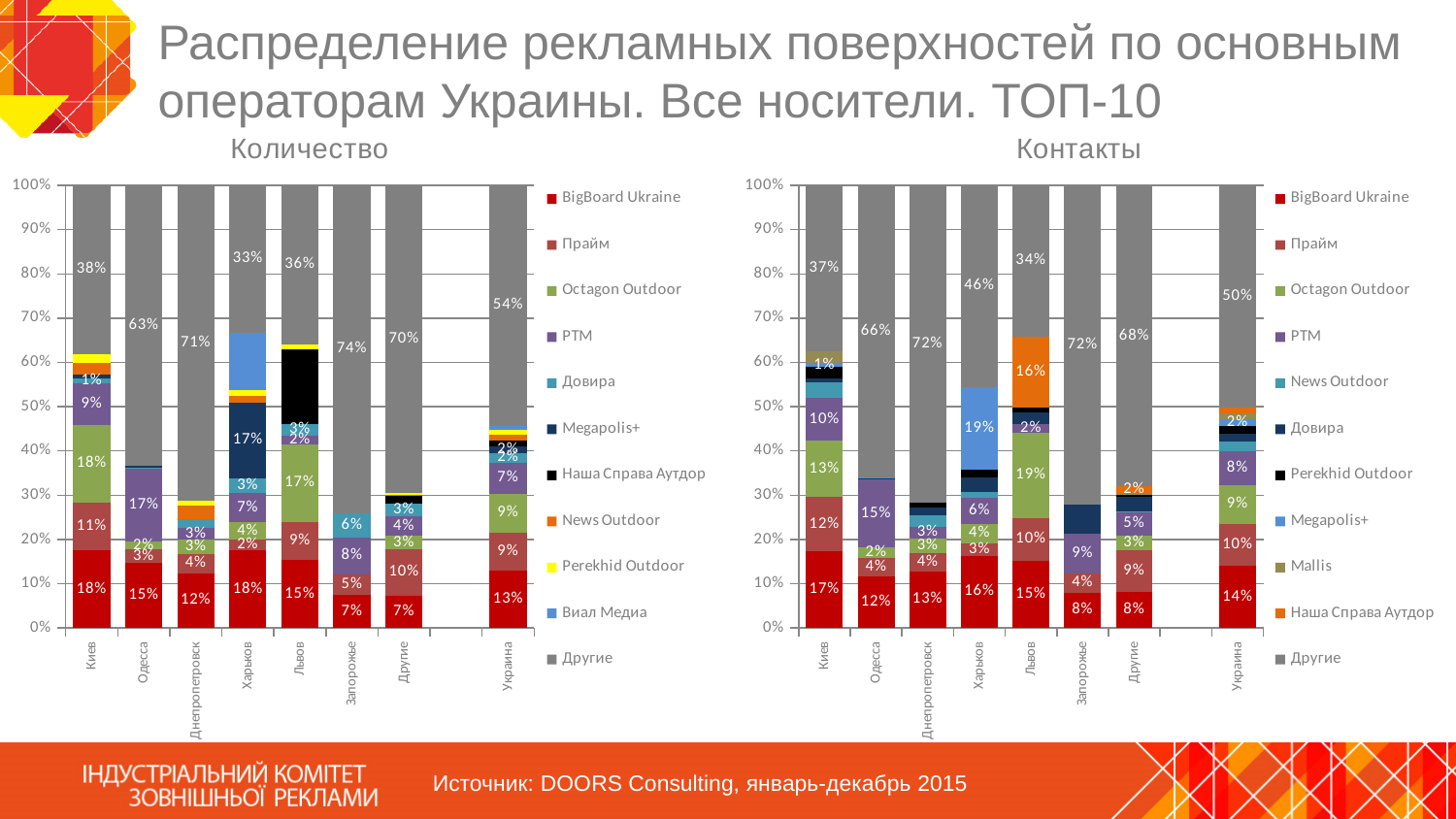
In the "Количество" chart, what is the difference between the "Другие" segment for Одесса and for Киев? 25 percentage points How many categories are shown on the x axis of the "Контакты" chart? 8 In the "Количество" chart, which category has the largest "Другие" segment? Запорожье How many series does the legend of the "Количество" chart list? 11 In the "Контакты" chart, which category has the smallest "Другие" segment? Львов In the "Контакты" chart, which is larger: the BigBoard Ukraine segment for Киев or for Одесса? Киев In the "Количество" chart, what is the value of the "Другие" segment for Запорожье? 74% What kind of chart is the "Количество" chart on the left? Stacked bar chart In the "Количество" chart, which category has the smallest "Другие" segment? Харьков In the "Контакты" chart, what is the value of the "Другие" segment for Львов? 34% In the "Контакты" chart, what is the value of the BigBoard Ukraine segment for Украина? 14% In the "Количество" chart, what is the value of the BigBoard Ukraine segment for Украина? 13%